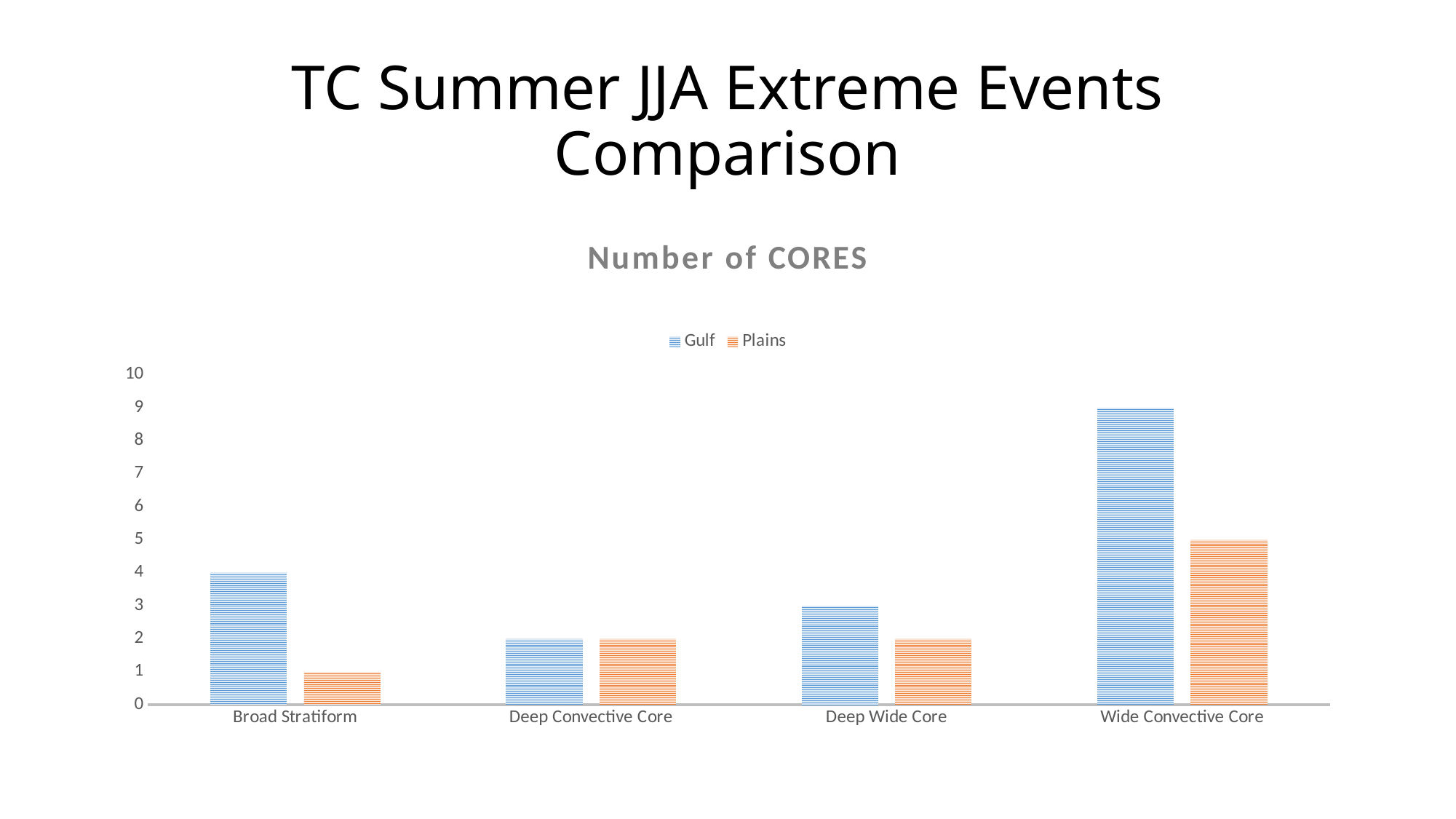
What type of chart is shown on the slide? Bar chart What is the Gulf value for Wide Convective Core? 9 How many series does the legend list? 2 What is the Plains value for Broad Stratiform? 1 What is the Gulf value for Deep Wide Core? 3 Is the Gulf value for Wide Convective Core greater or less than 5? greater Which is larger for Broad Stratiform, the Gulf value or the Plains value? Gulf How many categories are shown on the x axis? 4 What is the difference between the Gulf and Plains values for Wide Convective Core? 4 What is the title of the chart? Number of CORES Which category has the highest Gulf value? Wide Convective Core Which category has the lowest Plains value? Broad Stratiform